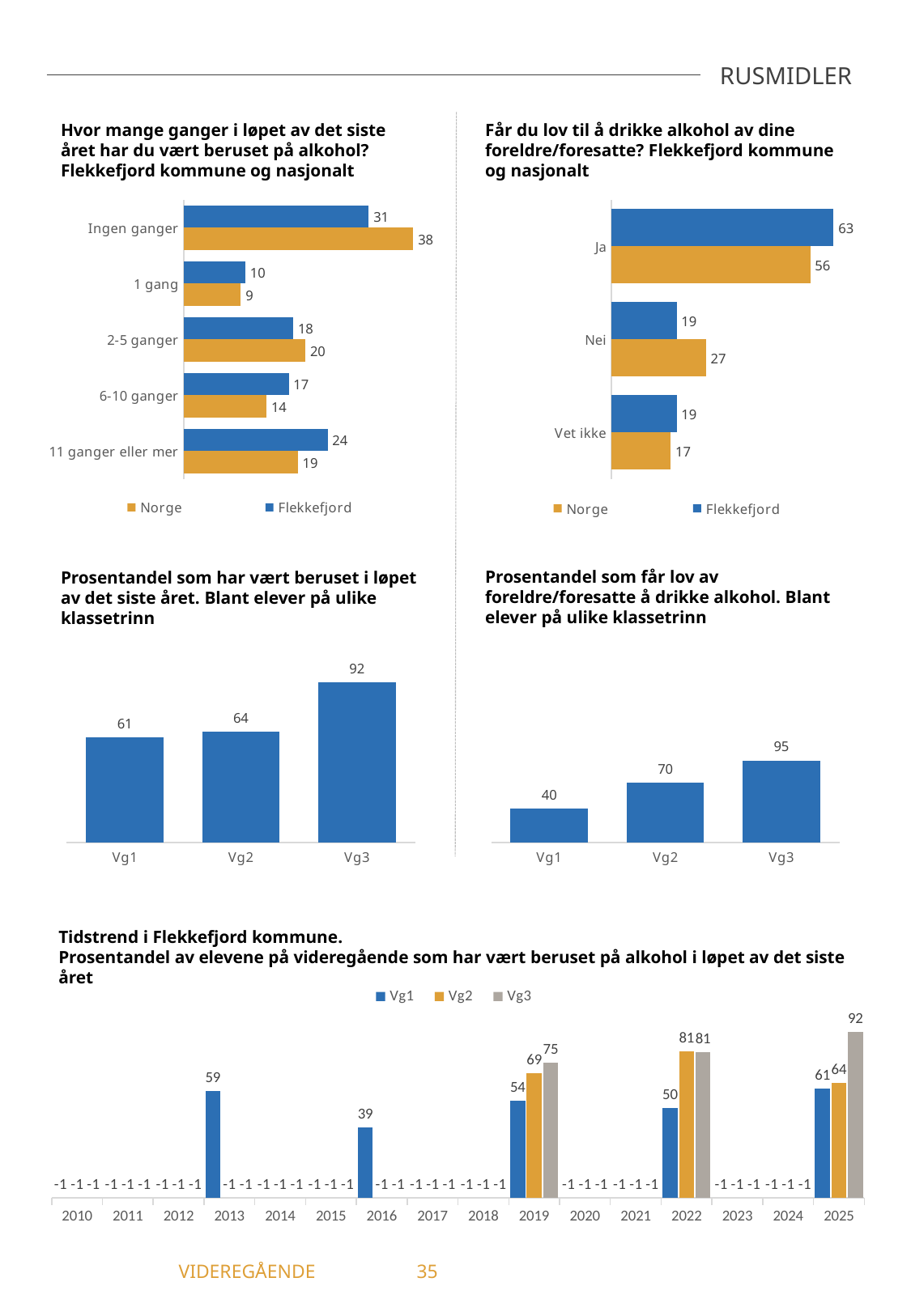
In the chart 'Får du lov til å drikke alkohol av dine foreldre/foresatte?', what is the value for Norge for 'Nei'? 27 In the chart 'Prosentandel som får lov av foreldre/foresatte å drikke alkohol', do the values rise or fall from Vg1 to Vg3? rise In the chart 'Tidstrend i Flekkefjord kommune', what is the value for Vg3 in 2025? 92 In the chart 'Hvor mange ganger i løpet av det siste året har du vært beruset på alkohol?', how many categories are shown? 5 In the chart 'Hvor mange ganger i løpet av det siste året har du vært beruset på alkohol?', what is the difference between Norge and Flekkefjord for '11 ganger eller mer'? 5 In the chart 'Hvor mange ganger i løpet av det siste året har du vært beruset på alkohol?', what is the value for Flekkefjord for 'Ingen ganger'? 31 In the chart 'Tidstrend i Flekkefjord kommune', what is the value for Vg1 in 2016? 39 In the chart 'Prosentandel som har vært beruset i løpet av det siste året', what is the value for Vg2? 64 In the chart 'Får du lov til å drikke alkohol av dine foreldre/foresatte?', how many series does the legend list? 2 In the chart 'Får du lov til å drikke alkohol av dine foreldre/foresatte?', which is larger for 'Ja': Flekkefjord or Norge? Flekkefjord In the chart 'Prosentandel som får lov av foreldre/foresatte å drikke alkohol', what is the difference between Vg3 and Vg1? 55 In the chart 'Prosentandel som har vært beruset i løpet av det siste året', which class level has the highest value? Vg3